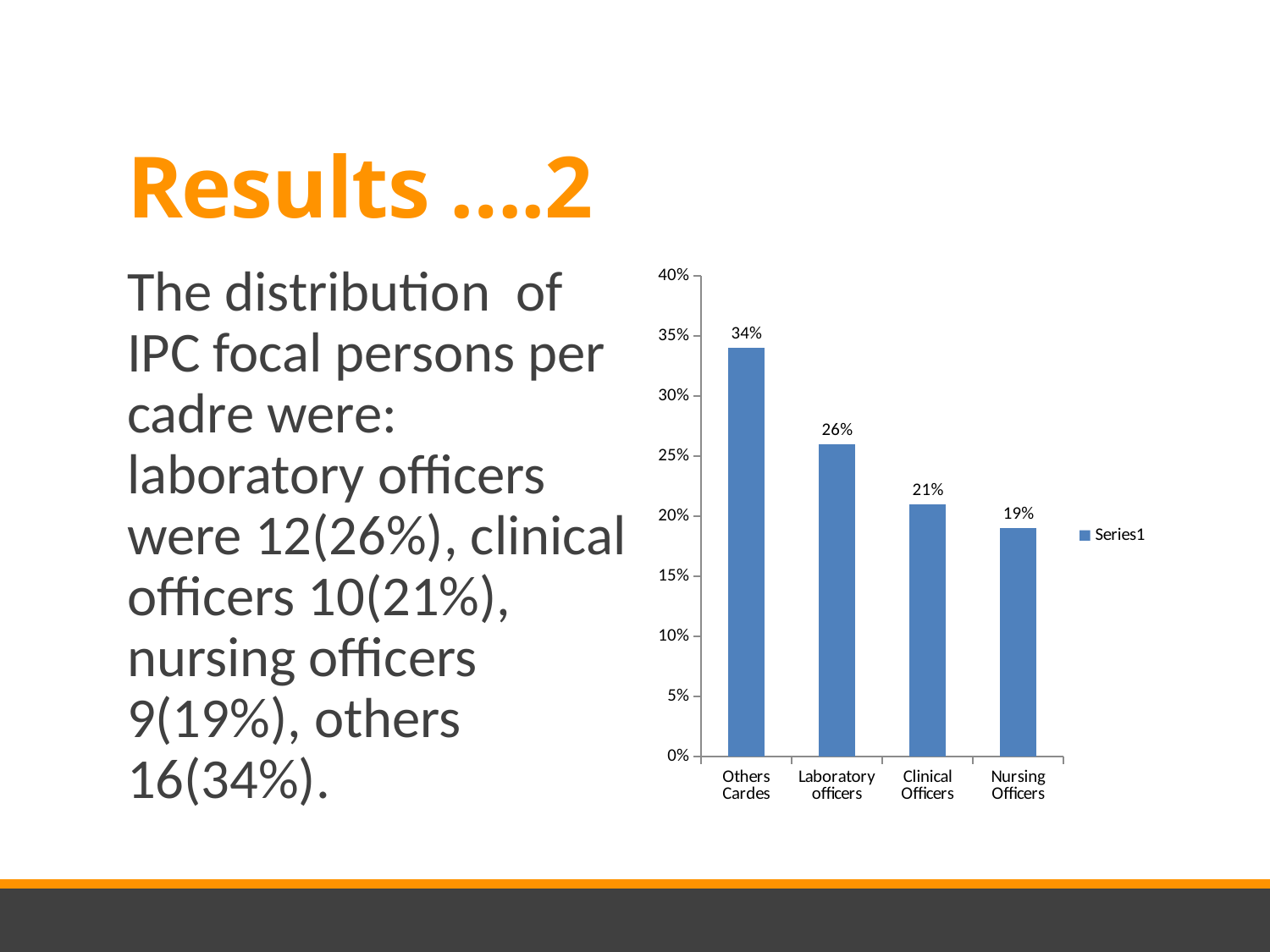
What is the difference between the values for Others Cardes and Laboratory officers? 8% What is the value for Clinical Officers? 21% Is the value for Laboratory officers greater or less than 25%? greater What kind of chart is shown on the slide? bar chart How many categories are shown on the x axis? 4 Which category has the highest value? Others Cardes What is the value for Laboratory officers? 26% What is the value for Others Cardes? 34% What is the value for Nursing Officers? 19% Do the values rise or fall from left to right along the x axis? fall Which is larger, the value for Clinical Officers or the value for Nursing Officers? Clinical Officers Which category has the lowest value? Nursing Officers